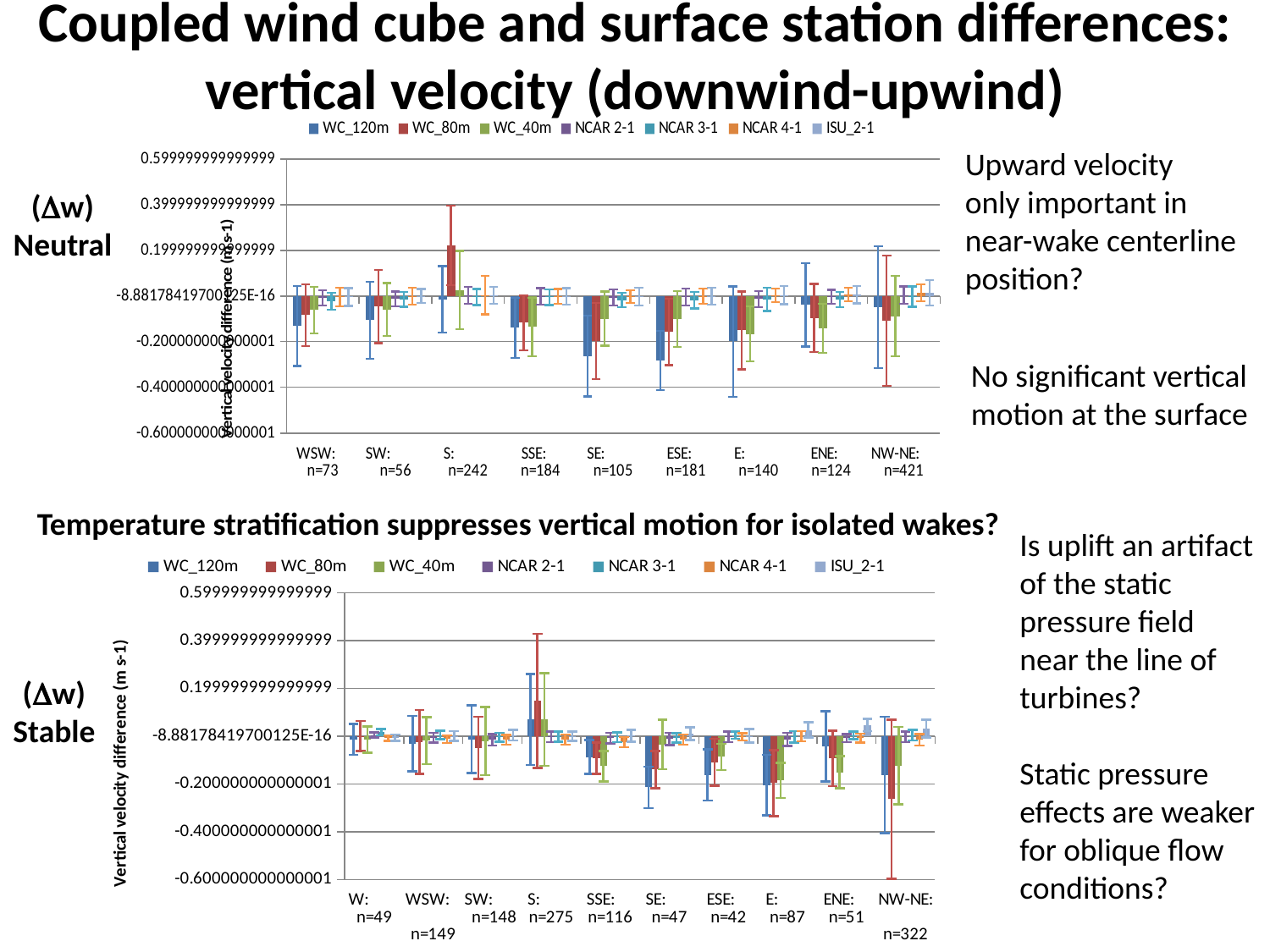
In the top (Neutral) chart, which category has the tallest positive WC_80m bar? S: n=242 What type of chart is the top (Neutral) chart on the slide? bar chart What is the first series listed in the legend of the bottom (Stable) chart? WC_120m How many series does the legend of the top (Neutral) chart list? 7 In the top (Neutral) chart, is the WC_80m value for S: n=242 greater or less than 0? greater How many wind-direction categories are shown on the x axis of the top (Neutral) chart? 9 In the bottom (Stable) chart, is the WC_120m value for SE: n=47 greater or less than 0? less In the top (Neutral) chart, which is larger: the WC_80m value for S: n=242 or the WC_80m value for WSW: n=73? S: n=242 What type of chart is the bottom (Stable) chart on the slide? bar chart How many wind-direction categories are shown on the x axis of the bottom (Stable) chart? 10 How many series does the legend of the bottom (Stable) chart list? 7 In the bottom (Stable) chart, which category has the tallest positive WC_80m bar? S: n=275